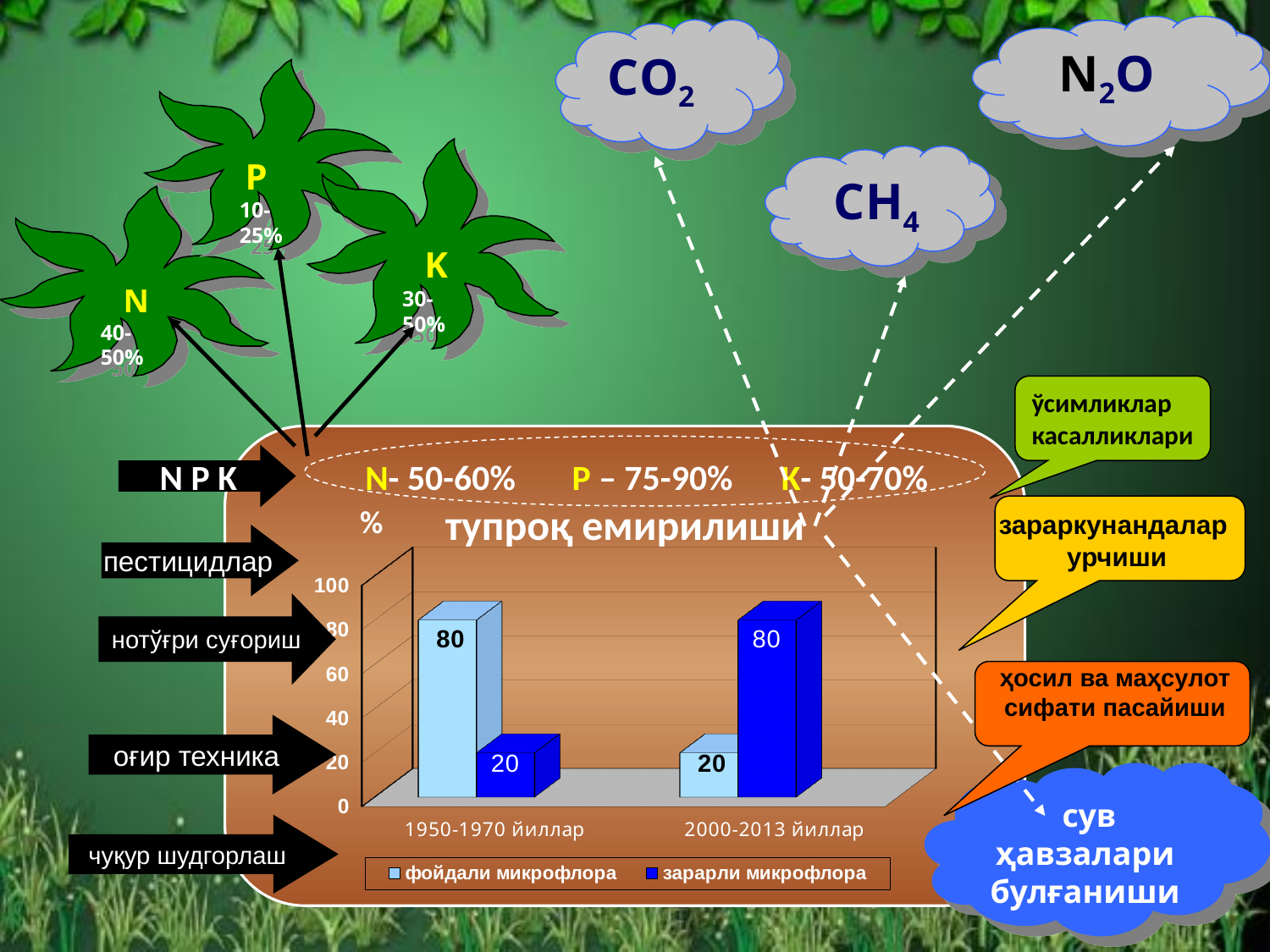
What is the difference between фойдали микрофлора and зарарли микрофлора in 1950-1970 йиллар? 60 What is the value for фойдали микрофлора in 2000-2013 йиллар? 20 What kind of chart is shown on the slide? bar chart How many categories are shown on the x axis of the chart? 2 In which period is зарарли микрофлора highest? 2000-2013 йиллар In which period is фойдали микрофлора lowest? 2000-2013 йиллар What is the value for зарарли микрофлора in 1950-1970 йиллар? 20 How many series does the chart legend list? 2 Which is larger in 2000-2013 йиллар: фойдали микрофлора or зарарли микрофлора? зарарли микрофлора What is the title of the chart? тупроқ емирилиши What is the value for фойдали микрофлора in 1950-1970 йиллар? 80 What is the value for зарарли микрофлора in 2000-2013 йиллар? 80